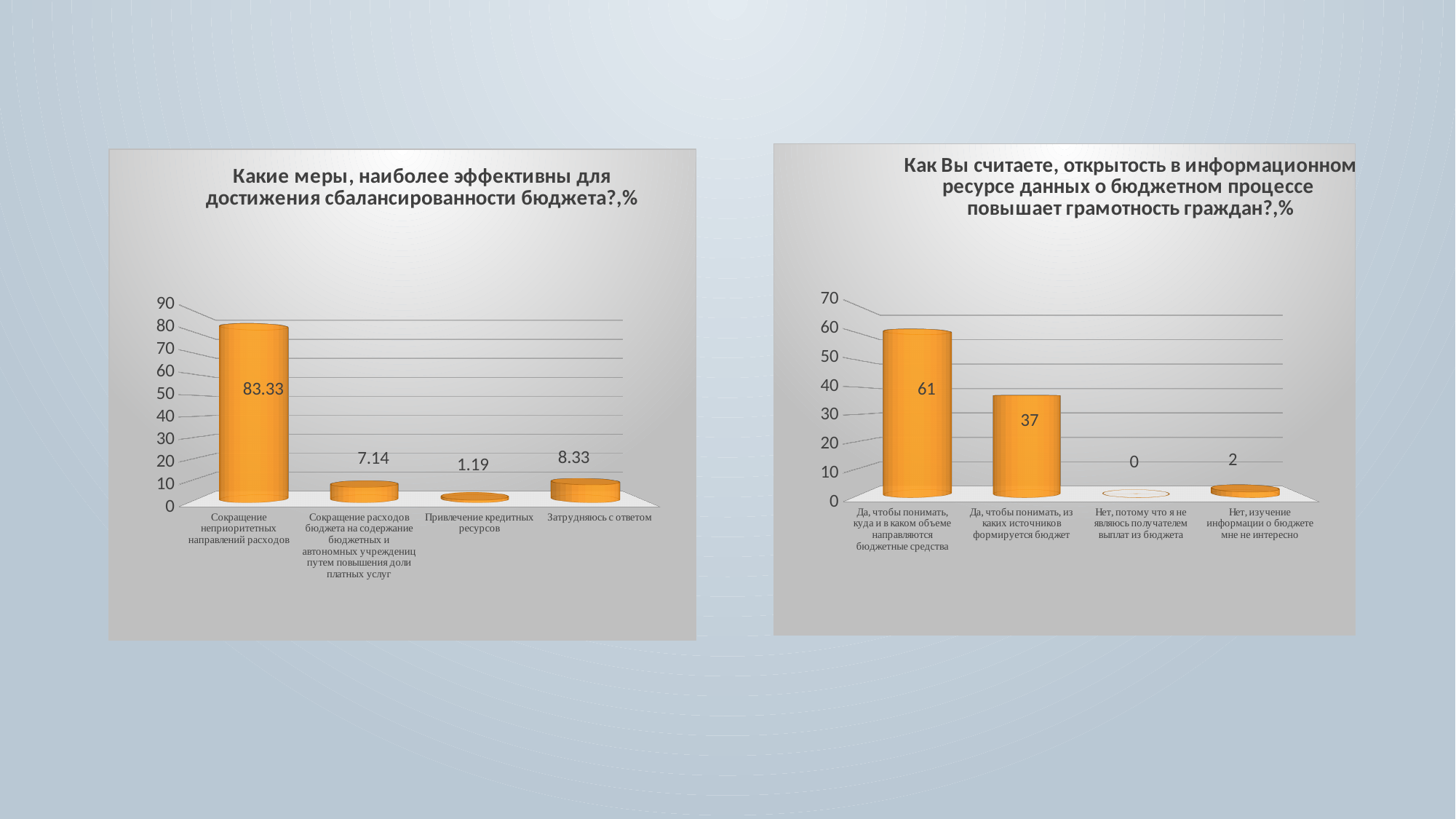
In the left chart, what is the value for 'Привлечение кредитных ресурсов'? 1.19 In the left chart, what is the difference between 'Затрудняюсь с ответом' and 'Привлечение кредитных ресурсов'? 7.14 In the left chart, which is larger: 'Затрудняюсь с ответом' or 'Сокращение расходов бюджета на содержание бюджетных и автономных учреждений путем повышения доли платных услуг'? Затрудняюсь с ответом How many categories does the left chart show? 4 What is the title of the left chart? Какие меры, наиболее эффективны для достижения сбалансированности бюджета?,% In the right chart, what is the value for 'Нет, изучение информации о бюджете мне не интересно'? 2 In the right chart, which category has the highest value? Да, чтобы понимать, куда и в каком объеме направляются бюджетные средства In the right chart, what is the value for 'Да, чтобы понимать, из каких источников формируется бюджет'? 37 In the right chart, what is the difference between the two 'Да' categories (61 and 37)? 24 In the left chart, which category has the lowest value? Привлечение кредитных ресурсов In the left chart, what is the value for 'Сокращение неприоритетных направлений расходов'? 83.33 What type of chart is the right chart? Bar chart